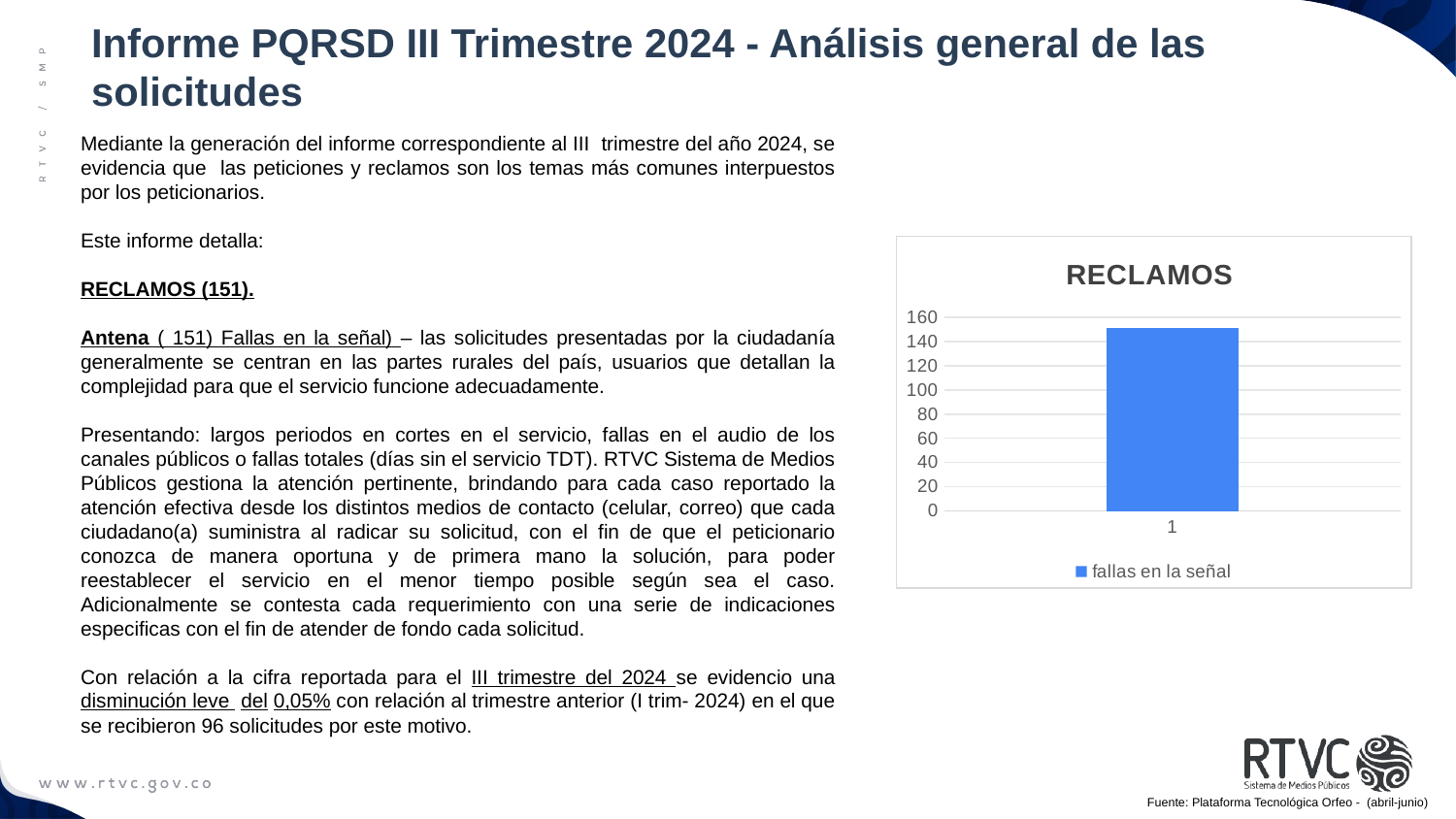
What is the highest value shown on the vertical axis of the chart? 160 How many bars are plotted in the chart? 1 What series name appears in the chart legend? fallas en la señal Is the value for fallas en la señal greater or less than 140? greater Is the value for fallas en la señal greater or less than 160? less What kind of chart is shown on the slide? bar chart What is the title of the chart? RECLAMOS How many series does the chart legend list? 1 Is the value for fallas en la señal greater or less than 100? greater